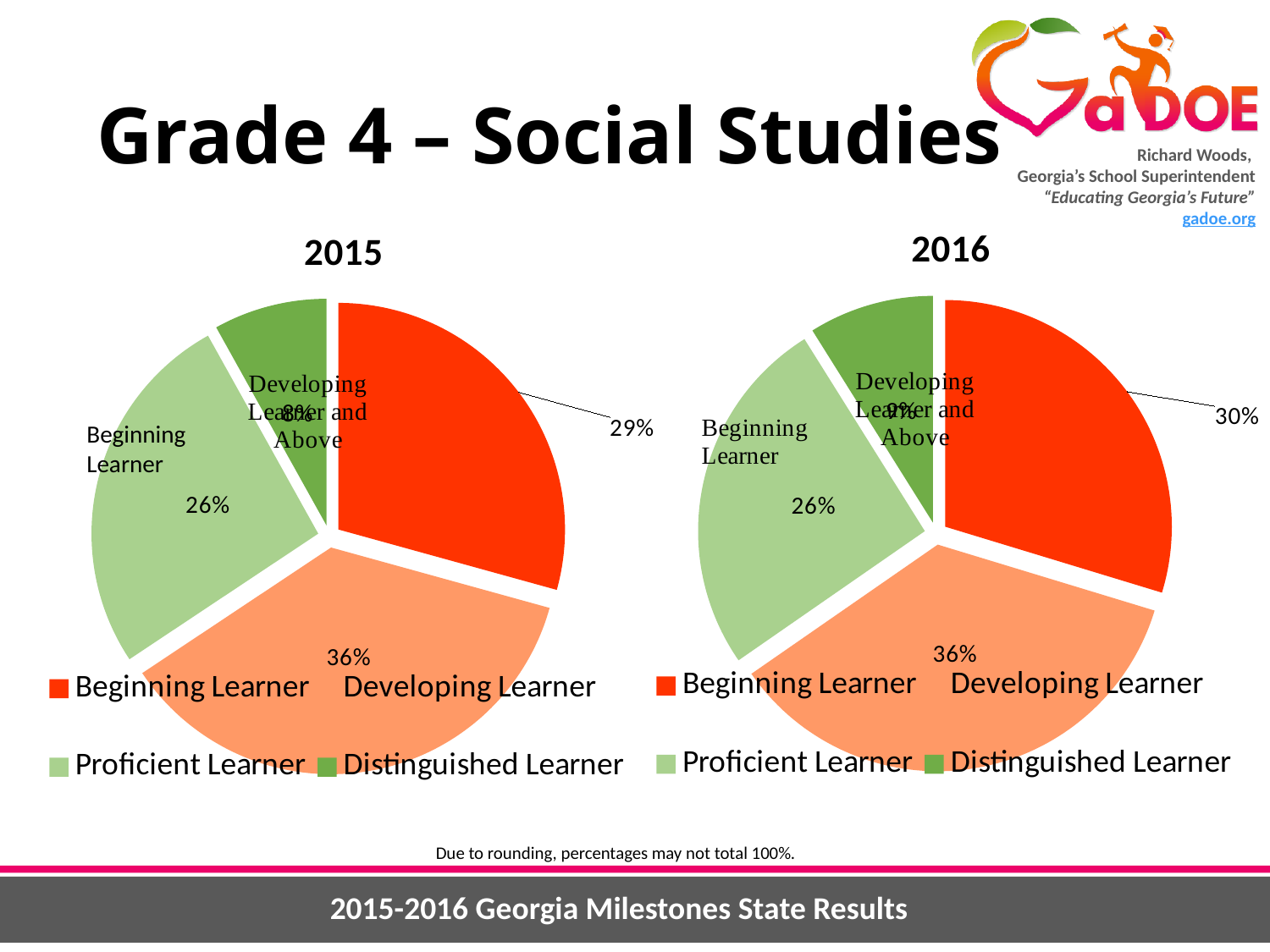
In the 2016 pie chart, what percentage is shown for Beginning Learner? 30% In the 2015 pie chart, what percentage is shown for Developing Learner? 36% In the 2016 chart's legend, what colour represents Beginning Learner? Red In the 2015 pie chart, what is the difference between the Developing Learner and Proficient Learner percentages? 10 percentage points In the 2016 pie chart, what percentage is shown for Proficient Learner? 26% In the 2015 pie chart, which is larger: Developing Learner or Proficient Learner? Developing Learner In the 2016 pie chart, which category has the smallest slice? Distinguished Learner How much higher is the Beginning Learner percentage in the 2016 chart than in the 2015 chart? 1 percentage point What type of chart is used for the 2015 data? Pie chart In the 2015 pie chart, what percentage is shown for Beginning Learner? 29% How many slices does the 2016 pie chart have? 4 In the 2015 pie chart, which category has the largest slice? Developing Learner